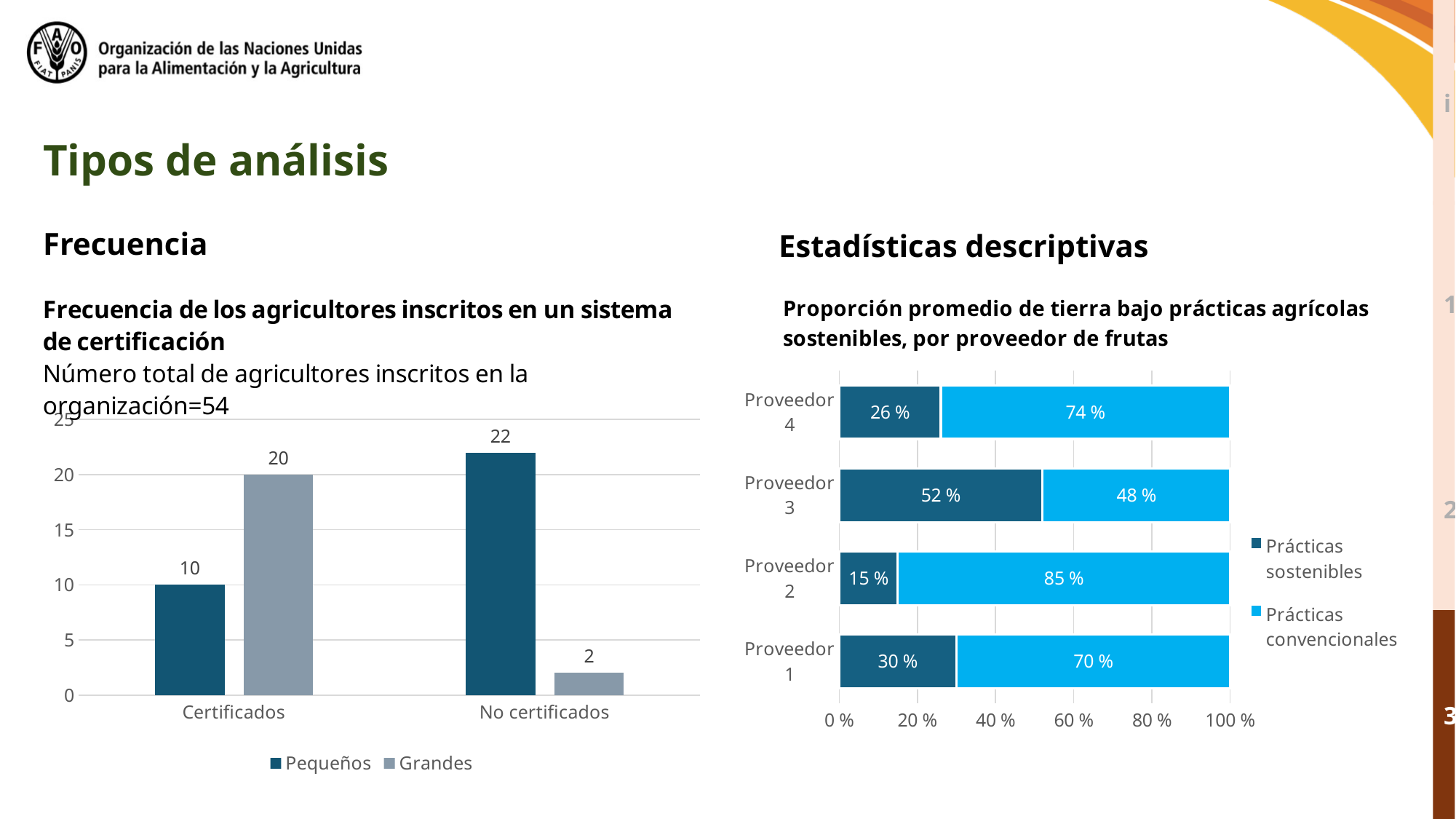
In the left chart (Frecuencia de los agricultores inscritos en un sistema de certificación), which is larger in the Certificados category, Pequeños or Grandes? Grandes In the left chart (Frecuencia de los agricultores inscritos en un sistema de certificación), what is the difference between Grandes Certificados and Grandes No certificados? 18 In the left chart (Frecuencia de los agricultores inscritos en un sistema de certificación), what is the value for Pequeños in the Certificados category? 10 In the right chart (Proporción promedio de tierra bajo prácticas agrícolas sostenibles, por proveedor de frutas), what is the difference between Prácticas convencionales and Prácticas sostenibles for Proveedor 4? 48 % In the left chart (Frecuencia de los agricultores inscritos en un sistema de certificación), how many series does the legend list? 2 In the right chart (Proporción promedio de tierra bajo prácticas agrícolas sostenibles, por proveedor de frutas), how many proveedores are shown? 4 In the right chart (Proporción promedio de tierra bajo prácticas agrícolas sostenibles, por proveedor de frutas), what is the total of the stacked bar for Proveedor 1? 100 % What kind of chart is the right chart (Proporción promedio de tierra bajo prácticas agrícolas sostenibles, por proveedor de frutas)? Stacked bar chart In the left chart (Frecuencia de los agricultores inscritos en un sistema de certificación), what is the value for Grandes in the No certificados category? 2 In the left chart (Frecuencia de los agricultores inscritos en un sistema de certificación), which bar has the highest value? Pequeños, No certificados In the right chart (Proporción promedio de tierra bajo prácticas agrícolas sostenibles, por proveedor de frutas), which proveedor has the lowest share of Prácticas sostenibles? Proveedor 2 In the right chart (Proporción promedio de tierra bajo prácticas agrícolas sostenibles, por proveedor de frutas), what is the value of Prácticas sostenibles for Proveedor 3? 52 %